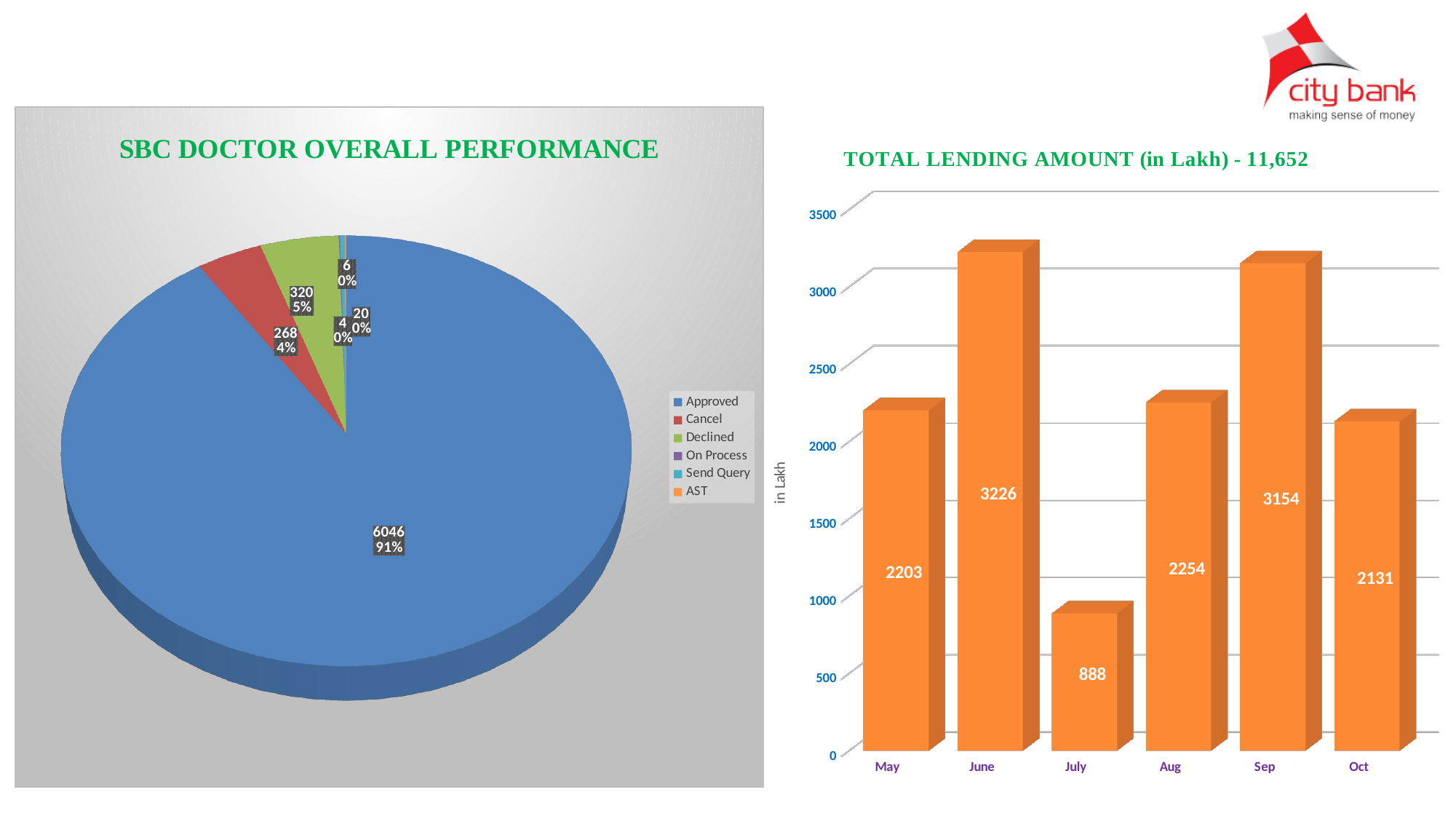
In the TOTAL LENDING AMOUNT chart, what is the value for July? 888 In the TOTAL LENDING AMOUNT chart, which month has the lowest value? July In the TOTAL LENDING AMOUNT chart, which month has the highest value? June In the TOTAL LENDING AMOUNT chart, how many months are shown on the x axis? 6 In the TOTAL LENDING AMOUNT chart, which is larger, the value for May or the value for Oct? May In the SBC DOCTOR OVERALL PERFORMANCE pie chart, what share of the pie is Approved? 91% What kind of chart is the TOTAL LENDING AMOUNT chart? Bar chart In the SBC DOCTOR OVERALL PERFORMANCE pie chart, which is larger, the Declined slice or the Cancel slice? Declined In the SBC DOCTOR OVERALL PERFORMANCE pie chart, what value is shown for Approved? 6046 In the TOTAL LENDING AMOUNT chart, what is the difference between the values for Sep and Aug? 900 In the SBC DOCTOR OVERALL PERFORMANCE pie chart, how many categories does the legend list? 6 In the TOTAL LENDING AMOUNT chart, what is the value for June? 3226